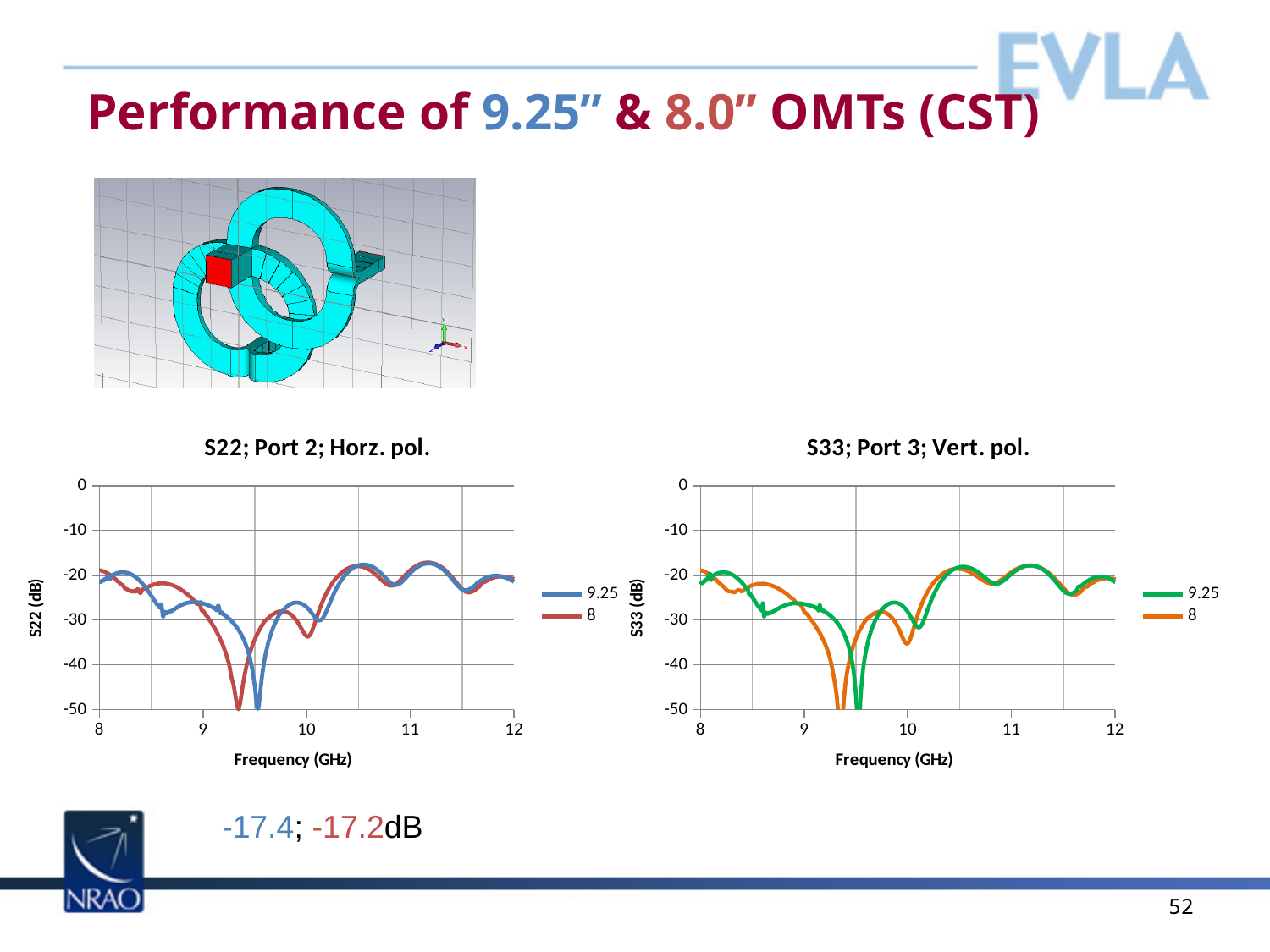
On the 'S33; Port 3; Vert. pol.' chart, is the value of the 8 series at 10 GHz greater or less than -30? less On the 'S33; Port 3; Vert. pol.' chart, is the value of the 9.25 series at 9 GHz greater or less than -40? greater On the 'S22; Port 2; Horz. pol.' chart, is the value of the 8 series at 11 GHz greater or less than -20? less What is the x-axis label on the 'S22; Port 2; Horz. pol.' chart? Frequency (GHz) How many series does the legend of the 'S33; Port 3; Vert. pol.' chart list? 2 How many series does the legend of the 'S22; Port 2; Horz. pol.' chart list? 2 What kind of chart is the 'S33; Port 3; Vert. pol.' chart? line chart What kind of chart is the 'S22; Port 2; Horz. pol.' chart? line chart What are the legend entries on the 'S33; Port 3; Vert. pol.' chart? 9.25 and 8